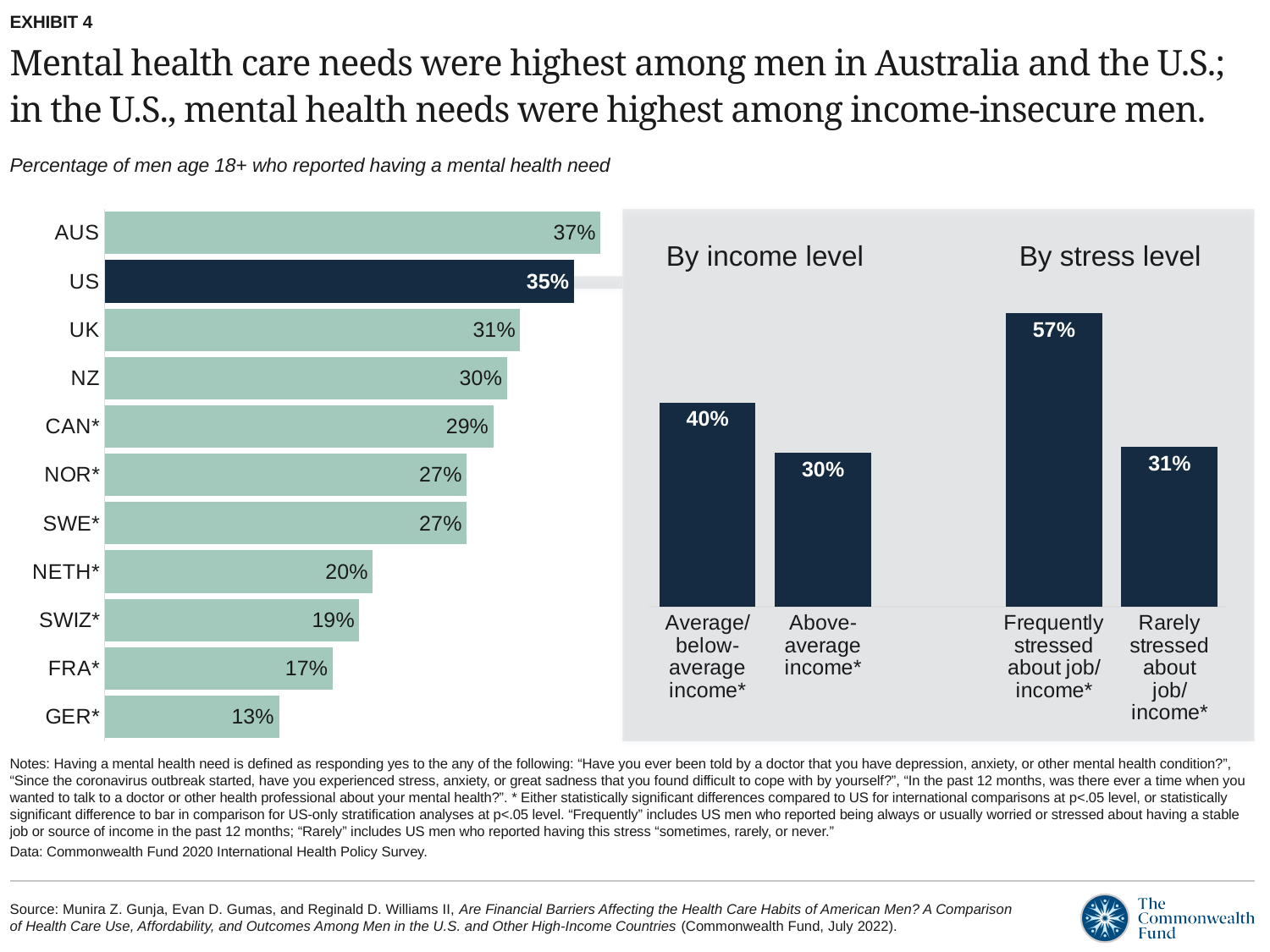
In the country bar chart on the left, which country has the lowest percentage? GER* In the country bar chart on the left, which country has the highest percentage? AUS In the 'By stress level' chart, what is the value for men frequently stressed about job/income? 57% In the country bar chart on the left, what is the value for the US? 35% In the country bar chart on the left, what percentage of men in Australia (AUS) reported having a mental health need? 37% In the country bar chart on the left, what is the difference between the values for AUS and GER*? 24 percentage points In the country bar chart on the left, which is larger, the value for UK or the value for NZ? UK In the country bar chart on the left, how many countries are shown? 11 In the 'By stress level' chart, which bar is higher, frequently stressed or rarely stressed? Frequently stressed about job/income* What type of chart is the country chart on the left? Bar chart In the 'By income level' chart, what is the difference between the average/below-average income bar and the above-average income bar? 10 percentage points In the 'By income level' chart, what is the value for men with average/below-average income? 40%